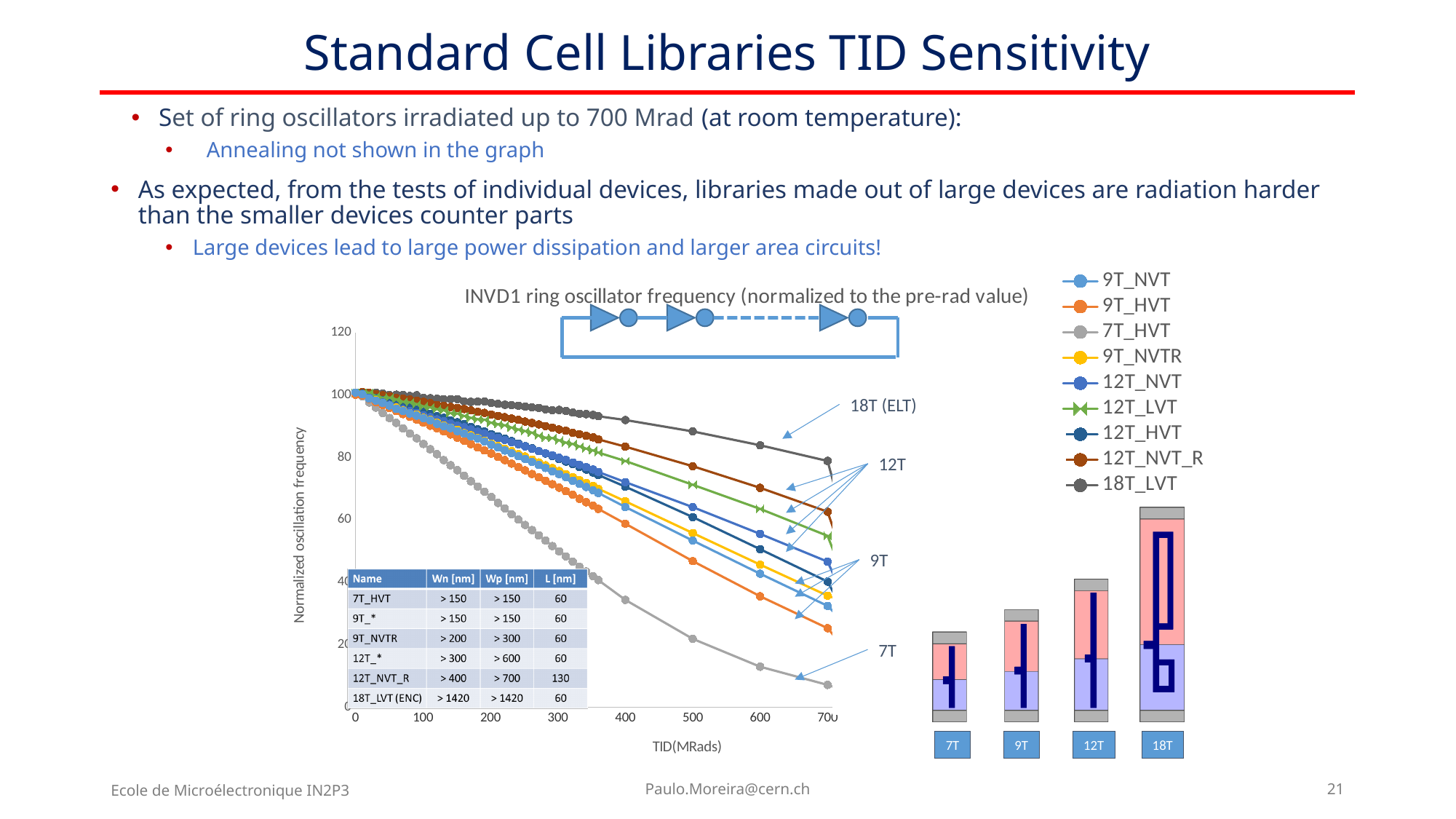
Is the value for 18T_LVT at 700 MRads greater or less than 60? greater Which series has the highest normalized oscillation frequency at 700 MRads? 18T_LVT At 500 MRads, which series has the larger value, 18T_LVT or 7T_HVT? 18T_LVT Do the normalized oscillation frequency values rise or fall as TID increases along the x axis? fall Is the value for 7T_HVT at 700 MRads greater or less than 20? less How many series does the chart legend list? 9 What kind of chart is shown on the slide? line chart What is the normalized oscillation frequency of all series at a TID of 0 MRads? 100 Which series has the lowest normalized oscillation frequency at 700 MRads? 7T_HVT What is the label of the x axis of the chart? TID(MRads) Is the value for 9T_HVT at 700 MRads greater or less than 40? less What is the title of the chart? INVD1 ring oscillator frequency (normalized to the pre-rad value)